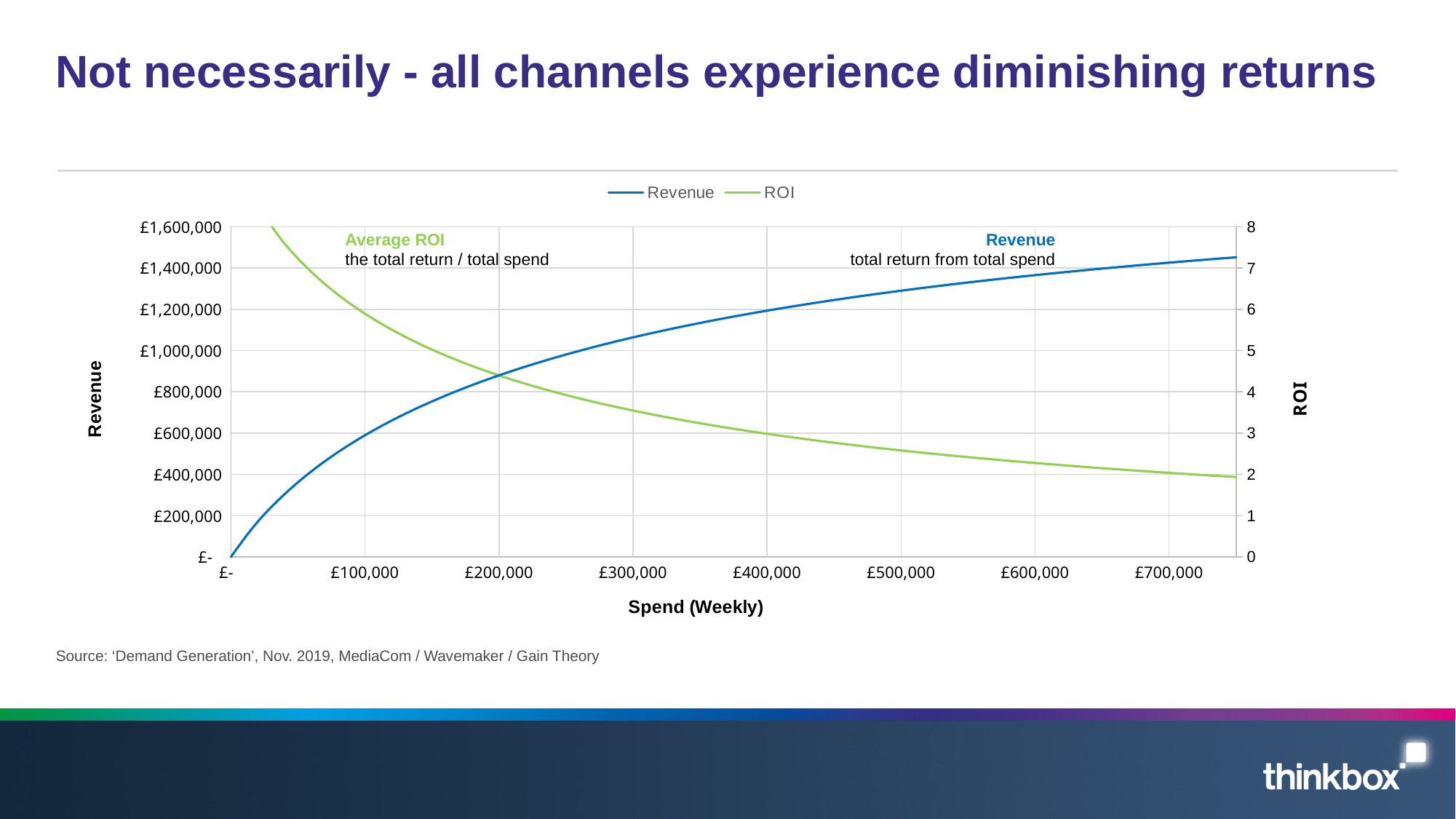
Is the Revenue value at a weekly spend of £700,000 greater or less than £1,200,000? greater What is the title of the chart's horizontal axis? Spend (Weekly) Does the Revenue line rise or fall as weekly spend increases? Rises Is the Revenue value at a weekly spend of £100,000 greater or less than £400,000? greater Is the ROI value at a weekly spend of £700,000 greater or less than 3? less How many series does the chart's legend list? 2 Does the ROI line rise or fall as weekly spend increases? Falls Which series is drawn in green on the chart? ROI What kind of chart is shown on the slide? Line chart